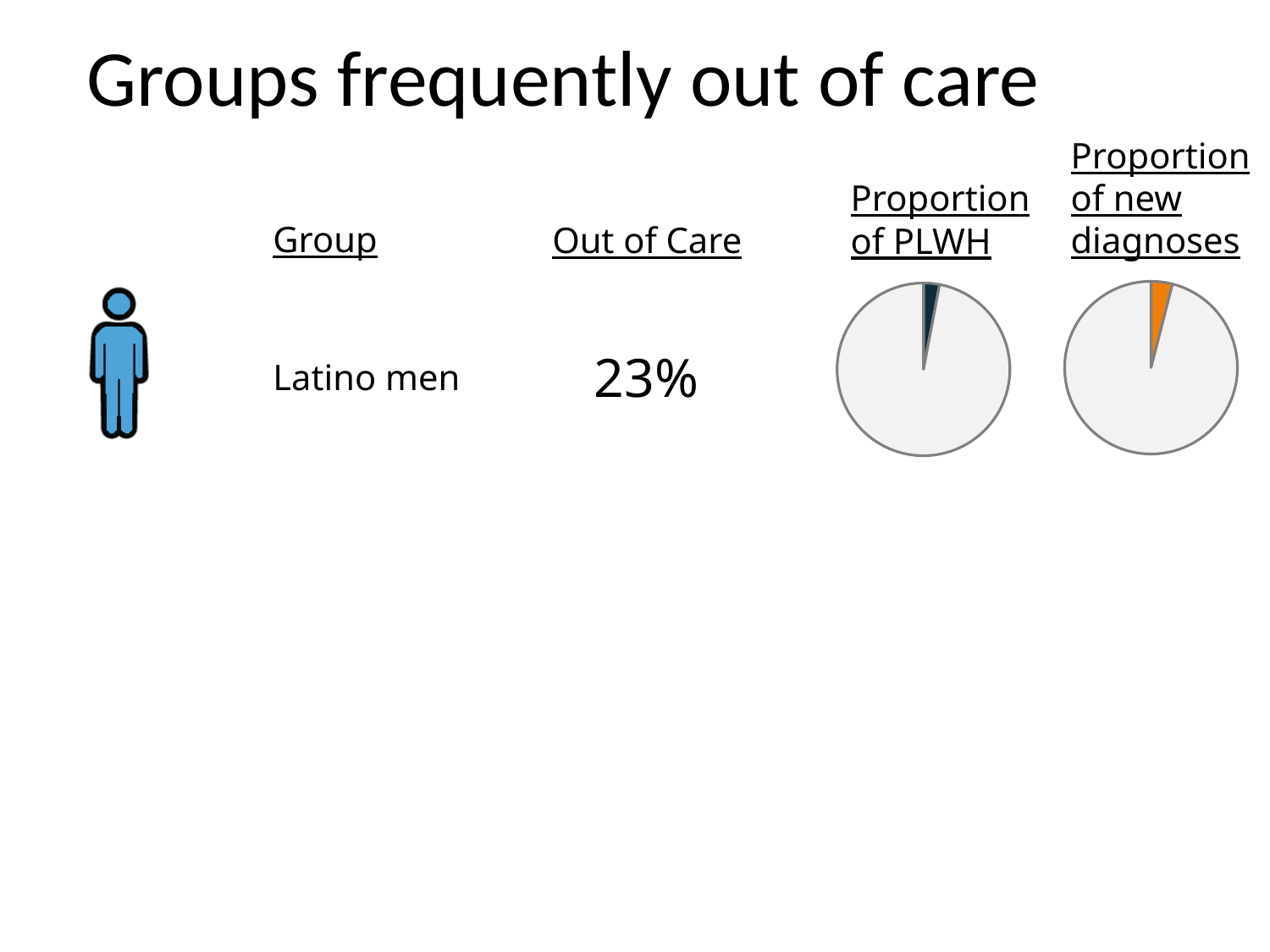
How many pie charts are shown on the slide? 2 Which group do the two pie charts on the slide refer to? Latino men What colour is the highlighted slice in the "Proportion of PLWH" pie chart? dark blue Which pie chart has the larger highlighted (coloured) slice, "Proportion of PLWH" or "Proportion of new diagnoses"? Proportion of new diagnoses What kind of chart is used under the heading "Proportion of new diagnoses"? pie chart What kind of chart is used under the heading "Proportion of PLWH"? pie chart How many slices does the "Proportion of new diagnoses" pie chart have? 2 In the "Proportion of new diagnoses" pie chart, which slice is larger, the orange slice or the light grey slice? the light grey slice In the "Proportion of PLWH" pie chart, which slice is larger, the dark blue slice or the light grey slice? the light grey slice What colour is the highlighted slice in the "Proportion of new diagnoses" pie chart? orange How many slices does the "Proportion of PLWH" pie chart have? 2